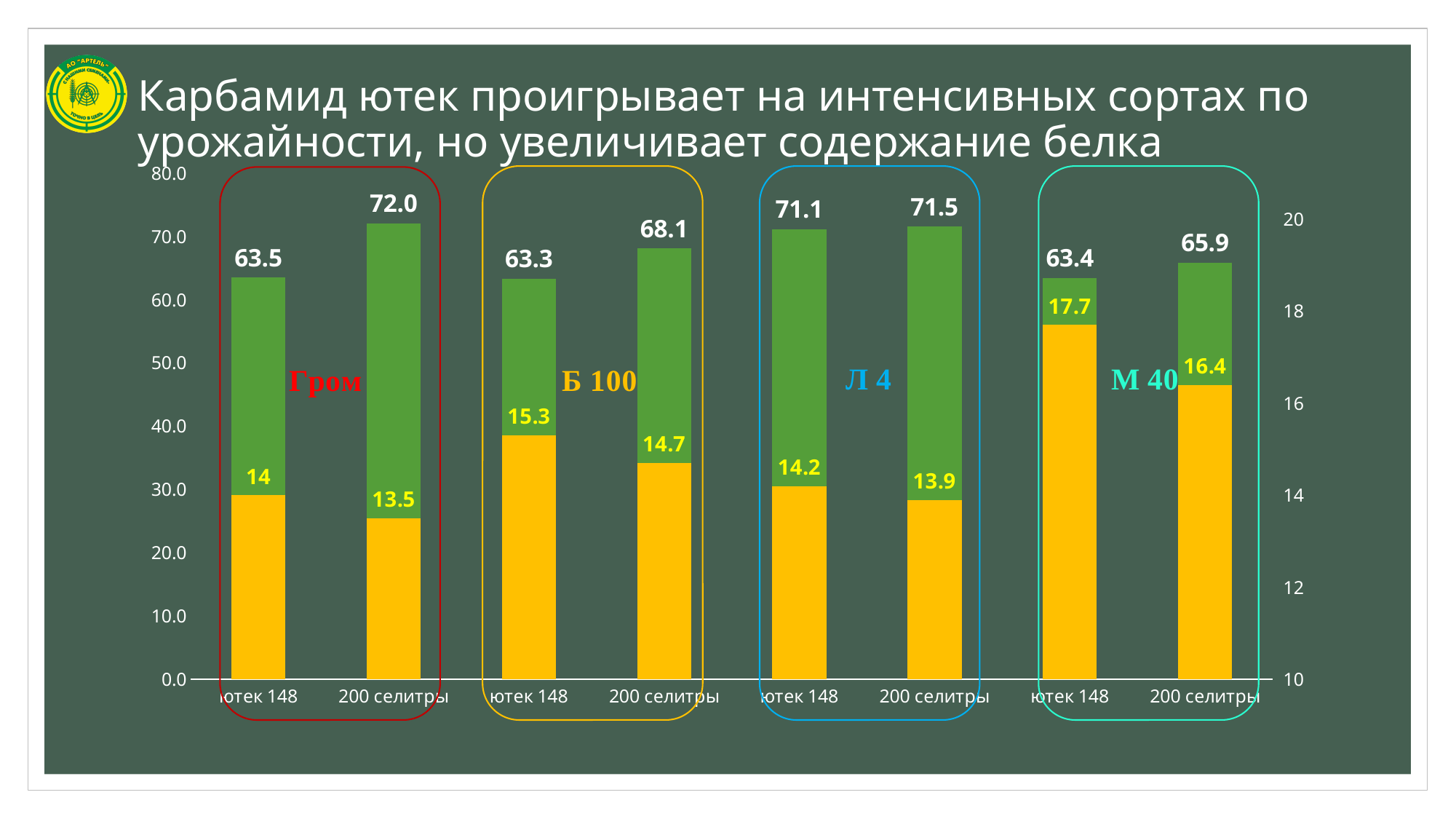
Which bar has the highest green value on the chart? 200 селитры in the Гром group (72.0) How many variety groups are outlined on the chart? 4 What is the value of the yellow bar for 200 селитры in the Л 4 group? 13.9 What is the value of the green bar for 200 селитры in the Б 100 group? 68.1 What is the value of the yellow bar for ютек 148 in the М 40 group? 17.7 What is the maximum value shown on the right-hand axis? 20 What kind of chart is shown on the slide? Bar chart What is the value of the green bar for ютек 148 in the Гром group? 63.5 In the Б 100 group, which has the larger yellow value, ютек 148 or 200 селитры? ютек 148 What is the difference between the yellow values for ютек 148 and 200 селитры in the М 40 group? 1.3 Which bar has the lowest yellow value on the chart? 200 селитры in the Гром group (13.5) What is the difference between the green values for 200 селитры and ютек 148 in the Гром group? 8.5